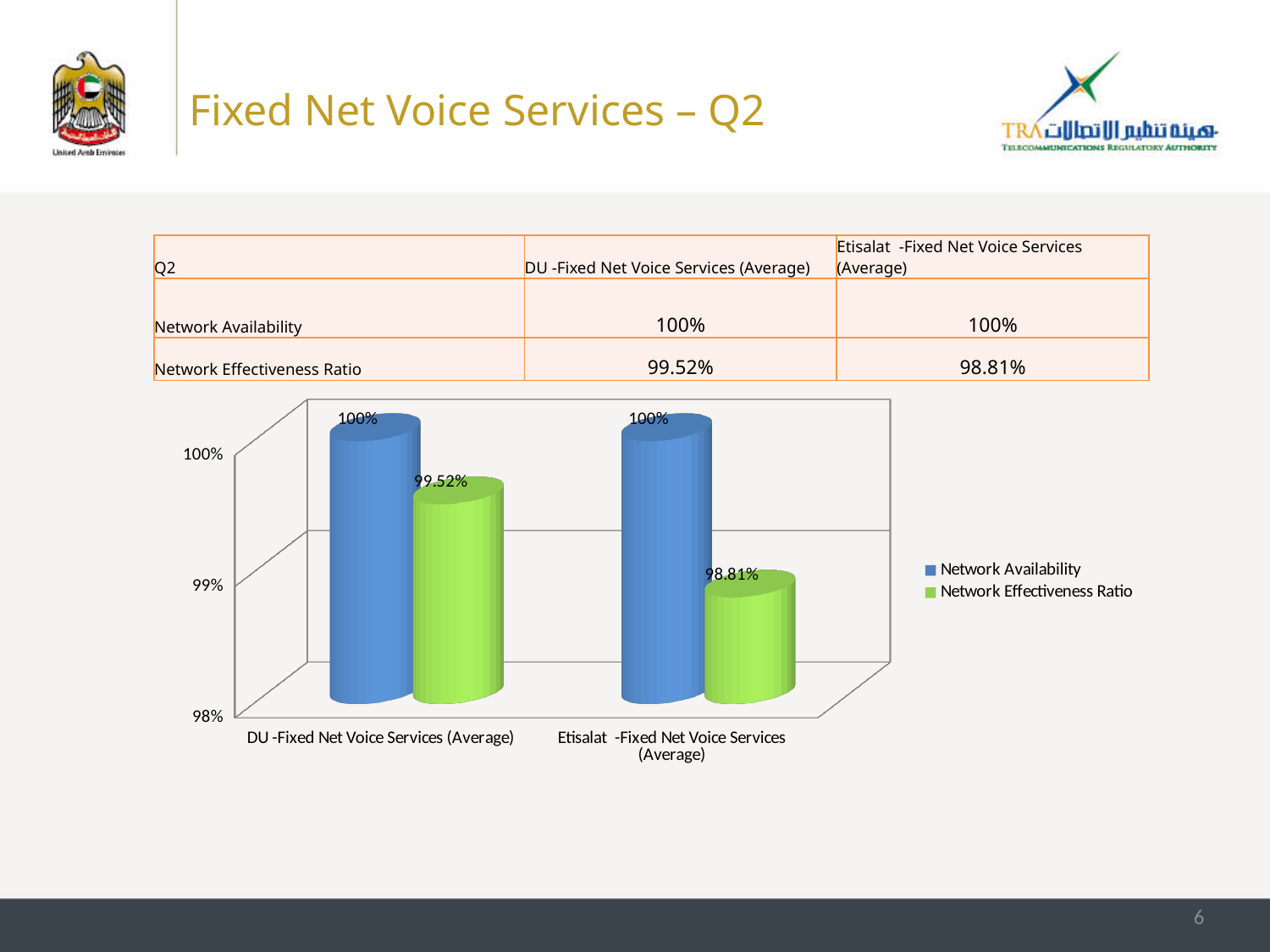
What is the Network Availability value for Etisalat - Fixed Net Voice Services (Average)? 100% What is the difference between Network Availability and Network Effectiveness Ratio for DU? 0.48% Which is larger: the Network Effectiveness Ratio for DU or for Etisalat? DU What is the difference between the Network Effectiveness Ratio of DU and Etisalat? 0.71% How many series does the chart legend list? 2 Which colour represents Network Effectiveness Ratio in the chart? Green How many categories are shown on the x axis of the chart? 2 What kind of chart is shown on the slide? Bar chart What is the Network Effectiveness Ratio for Etisalat - Fixed Net Voice Services (Average)? 98.81% What is the Network Effectiveness Ratio for DU - Fixed Net Voice Services (Average)? 99.52% Is the Network Effectiveness Ratio for Etisalat greater or less than 99%? less Which operator has the lower Network Effectiveness Ratio? Etisalat - Fixed Net Voice Services (Average)